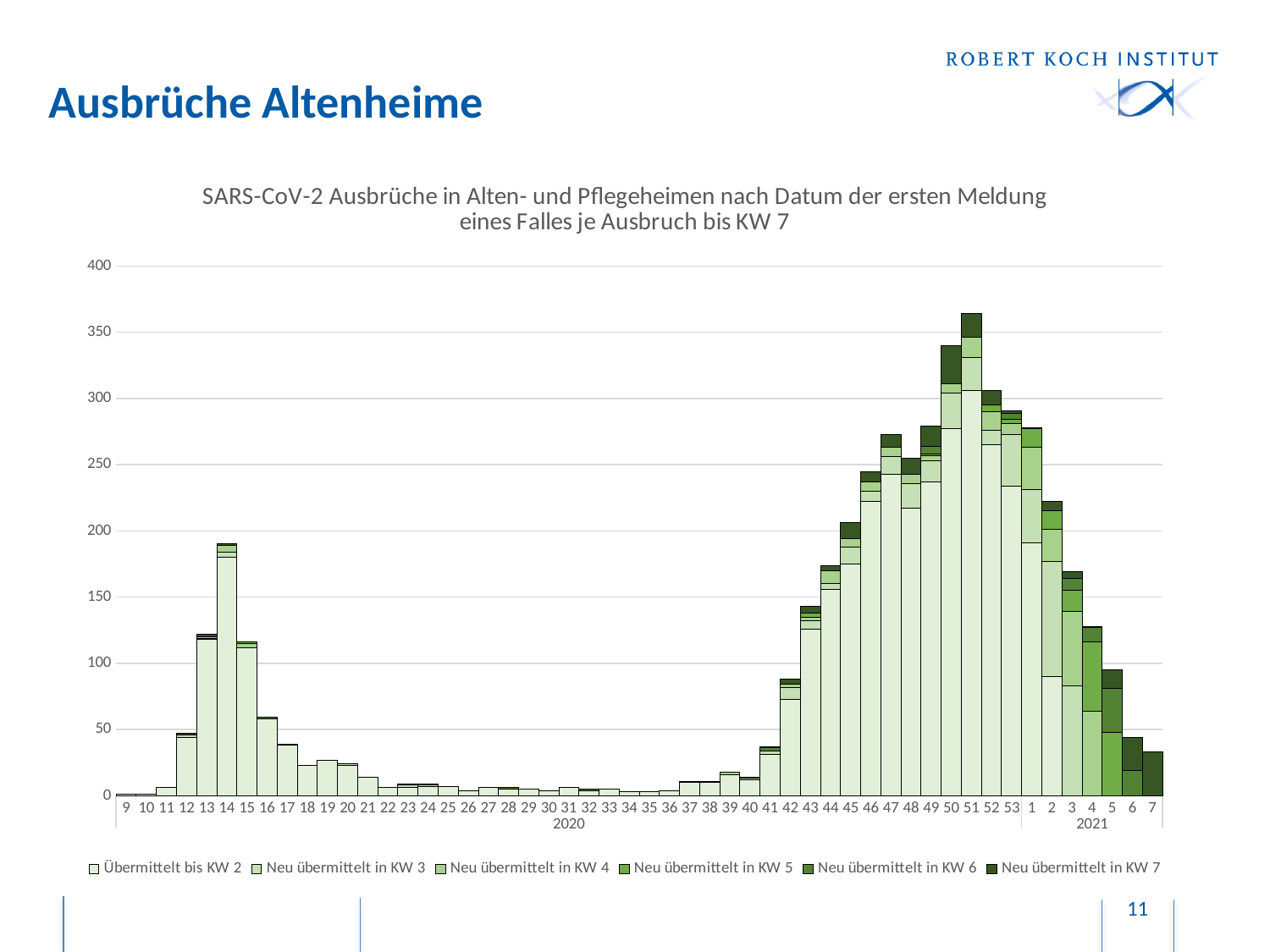
How many calendar weeks (bars) are shown on the x axis in total? 52 Which calendar week has the highest total number of outbreaks? KW 51 2020 How many series does the legend list? 6 Which has the larger total, KW 14 2020 or KW 13 2020? KW 14 2020 Which has the larger total, KW 3 2021 or KW 6 2021? KW 3 2021 What is the first series listed in the legend? Übermittelt bis KW 2 What kind of chart is shown on the slide? stacked bar chart Is the total value for KW 46 2020 greater or less than 200? greater Is the total value for KW 51 2020 greater or less than 350? greater Do the totals rise or fall from KW 1 2021 to KW 7 2021? fall Is the total value for KW 14 2020 greater or less than 150? greater